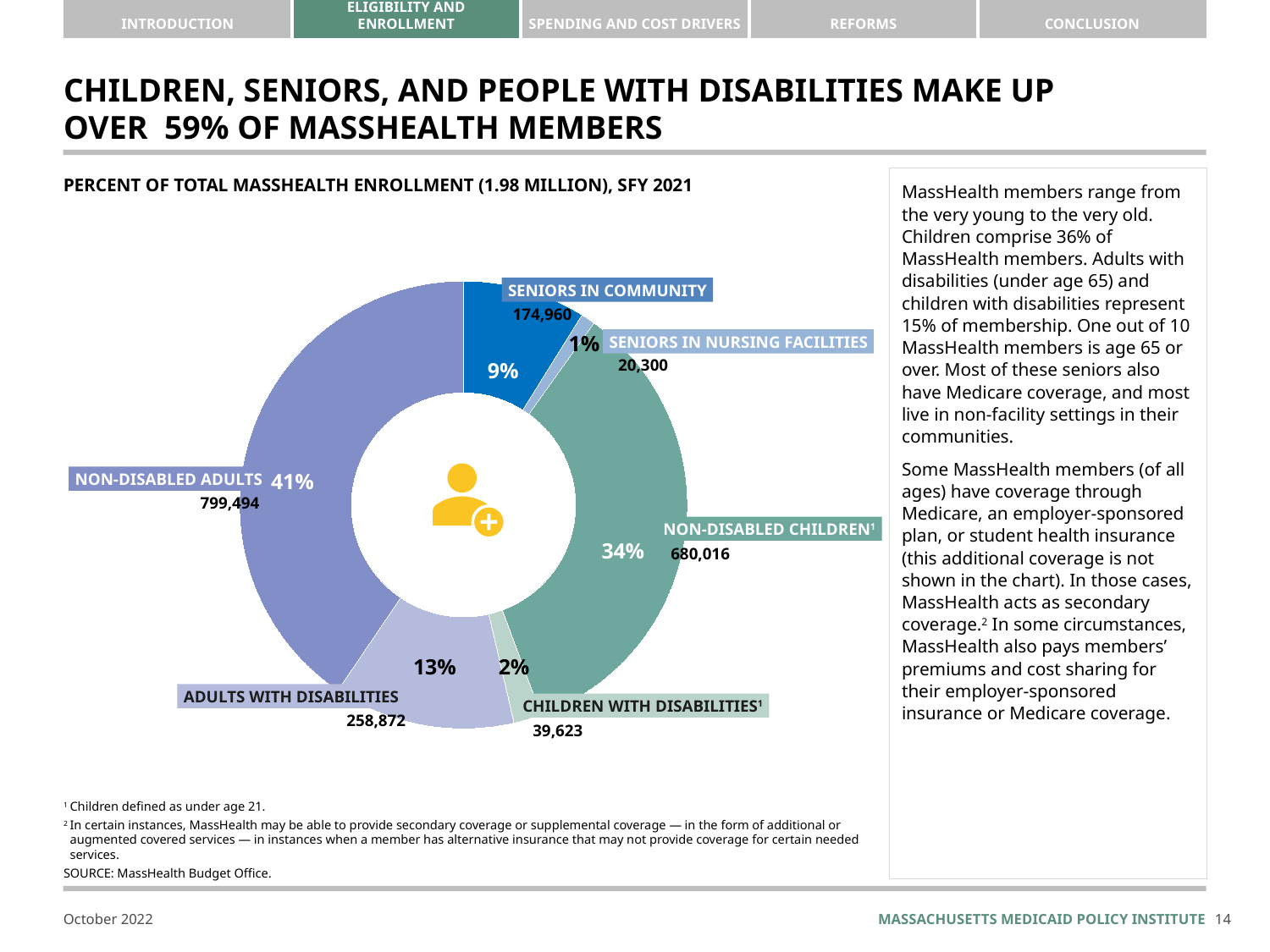
What is the title of the chart? Percent of Total MassHealth Enrollment (1.98 Million), SFY 2021 How many categories are shown in the chart? 6 Which category has the smallest share of MassHealth enrollment? Seniors in Nursing Facilities Which has a larger enrollment, Seniors in Community or Children with Disabilities? Seniors in Community What is the enrollment count for Non-Disabled Adults? 799,494 What is the difference in enrollment between Non-Disabled Adults and Non-Disabled Children? 119,478 What kind of chart is shown on the slide? Donut (pie) chart Which category has the largest share of MassHealth enrollment? Non-Disabled Adults What percent of total MassHealth enrollment is Non-Disabled Children? 34% What is the enrollment count for Seniors in Nursing Facilities? 20,300 What is the combined percentage share of Seniors in Community and Seniors in Nursing Facilities? 10% What percent of total MassHealth enrollment is Adults with Disabilities? 13%